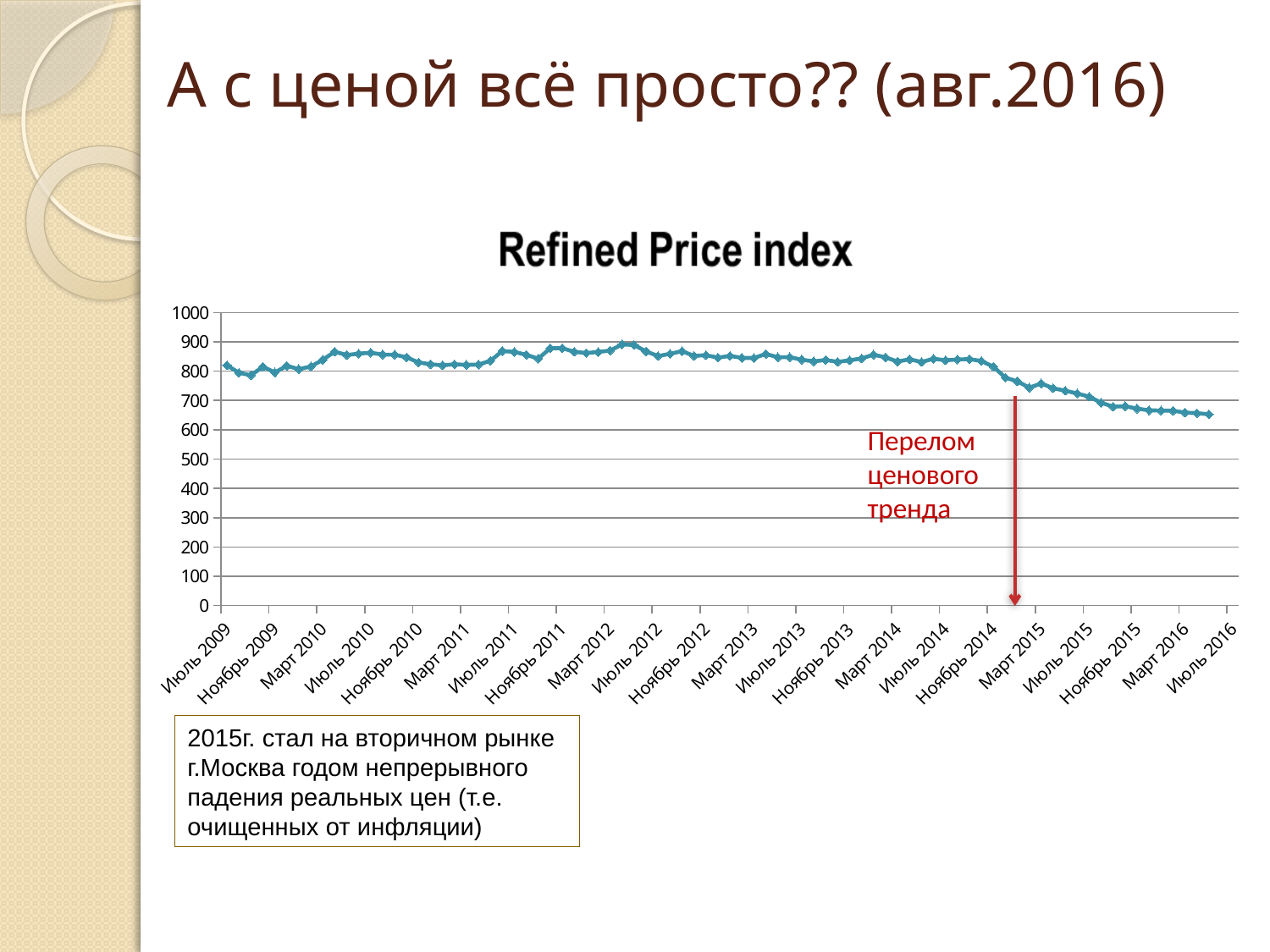
What kind of chart is shown on the slide? Line chart Is the value for Март 2014 greater or less than 800? greater Do the values rise or fall from Ноябрь 2014 to Июль 2016? fall What text does the red annotation on the chart say? Перелом ценового тренда Is the value for Июль 2012 greater or less than 800? greater Is the value for Июль 2009 greater or less than 800? greater What is the title of the chart? Refined Price index